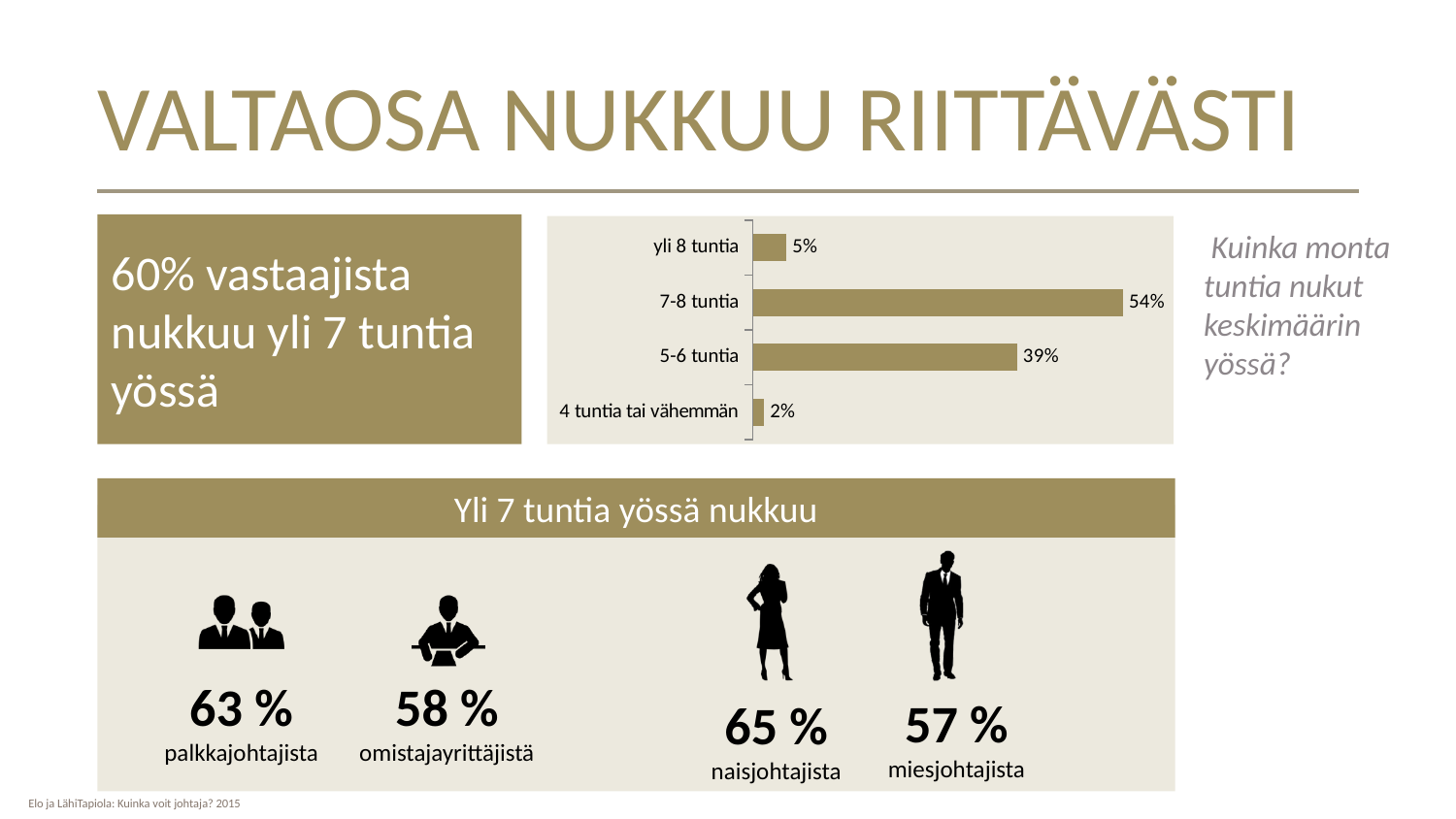
What is the value shown for 5-6 tuntia in the bar chart? 39% Which category has the lowest value in the bar chart? 4 tuntia tai vähemmän How many categories are shown in the bar chart? 4 What is the title of the slide containing the bar chart? VALTAOSA NUKKUU RIITTÄVÄSTI What type of chart is used to show the sleep hours distribution? Bar chart What is the value shown for yli 8 tuntia in the bar chart? 5% Which is larger in the bar chart, the value for yli 8 tuntia or the value for 4 tuntia tai vähemmän? yli 8 tuntia What is the value shown for 4 tuntia tai vähemmän in the bar chart? 2% What is the difference between the values for 7-8 tuntia and 5-6 tuntia in the bar chart? 15% Which category has the highest value in the bar chart? 7-8 tuntia What is the difference between the values for yli 8 tuntia and 4 tuntia tai vähemmän in the bar chart? 3% What percentage of respondents sleep 7-8 tuntia according to the bar chart? 54%